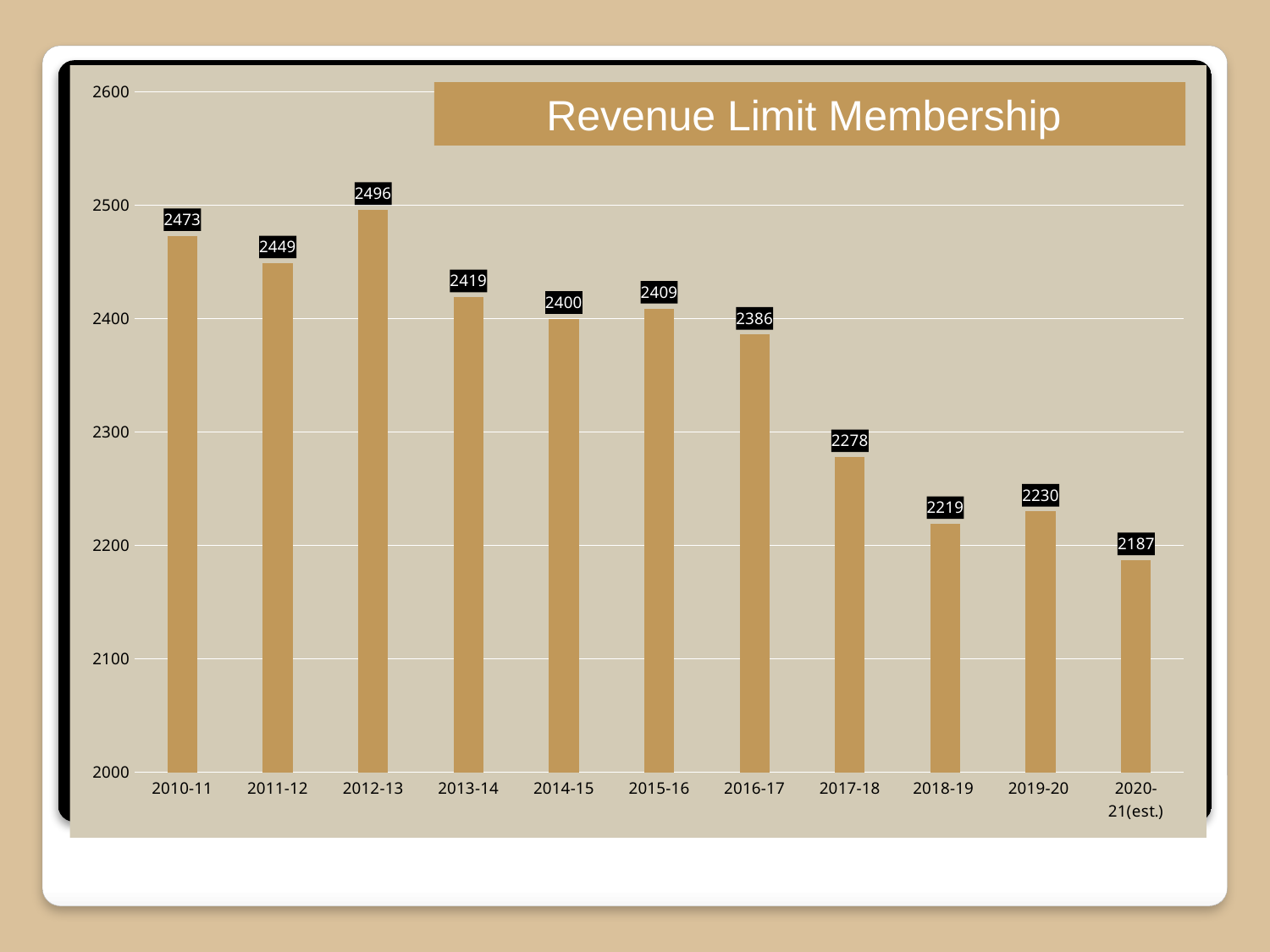
Is the Revenue Limit Membership for 2018-19 greater or less than 2300? less What is the difference in Revenue Limit Membership between 2010-11 and 2011-12? 24 Which year has the lowest Revenue Limit Membership? 2020-21(est.) Which year has a higher Revenue Limit Membership, 2014-15 or 2015-16? 2015-16 What is the estimated Revenue Limit Membership for 2020-21? 2187 What is the Revenue Limit Membership for 2017-18? 2278 How many years are shown on the chart? 11 What is the title of the chart? Revenue Limit Membership What is the Revenue Limit Membership for 2012-13? 2496 Which year has the highest Revenue Limit Membership? 2012-13 What type of chart is shown on the slide? Bar chart By how much did Revenue Limit Membership fall from 2016-17 to 2017-18? 108